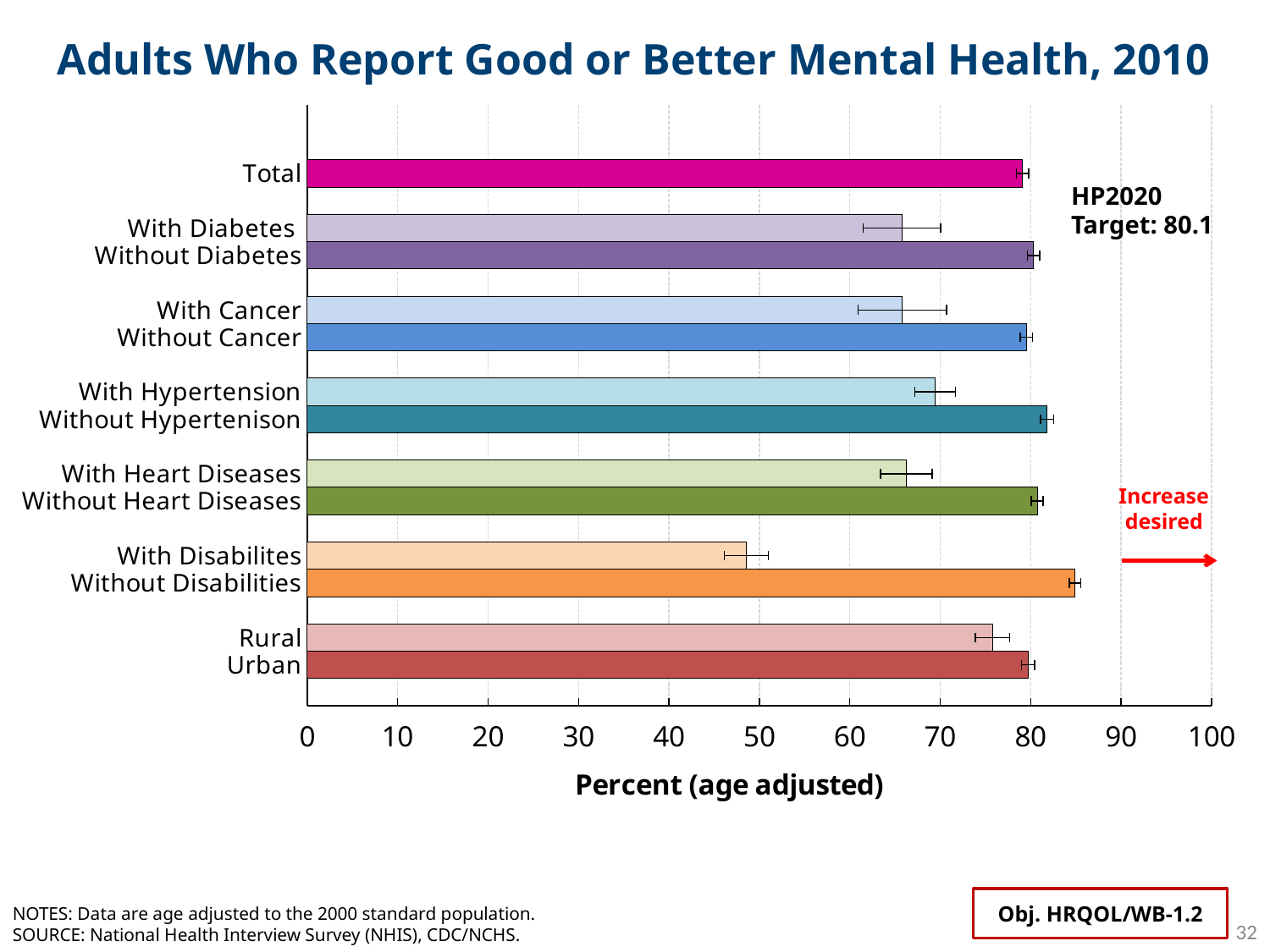
Which category has the lowest value in the chart? With Disabilites Which is larger, the value for With Cancer or Without Cancer? Without Cancer Is the value for With Disabilites greater or less than 50? less What kind of chart is shown on the slide? bar chart Is the value for With Diabetes greater or less than 70? less How many bars (categories) are plotted in the chart? 13 What is the title of the x axis? Percent (age adjusted) Which is larger, the value for Rural or Urban? Urban Which category has the highest value in the chart? Without Disabilities What is the HP2020 target shown on the slide? 80.1 Is the value for Rural greater or less than 70? greater